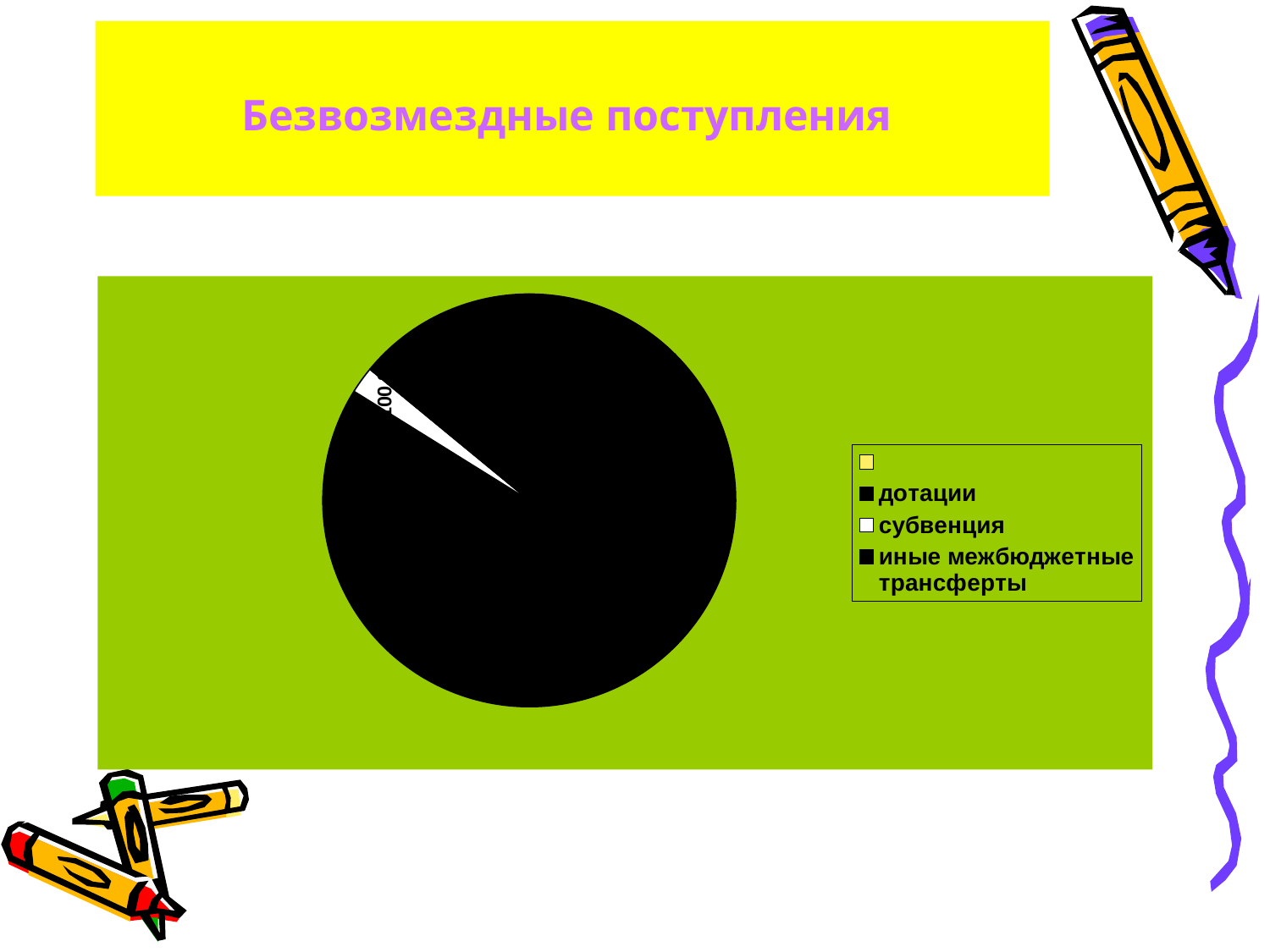
What is the title of the slide containing the pie chart? Безвозмездные поступления Which category does the white slice of the pie chart represent? субвенция Does the субвенция slice make up more or less than half of the pie? less What kind of chart is shown on the slide? pie chart How many labelled entries does the legend of the pie chart list? 3 Which legend entry of the pie chart is shown in white? субвенция Is the субвенция slice the smallest visible slice of the pie chart? yes